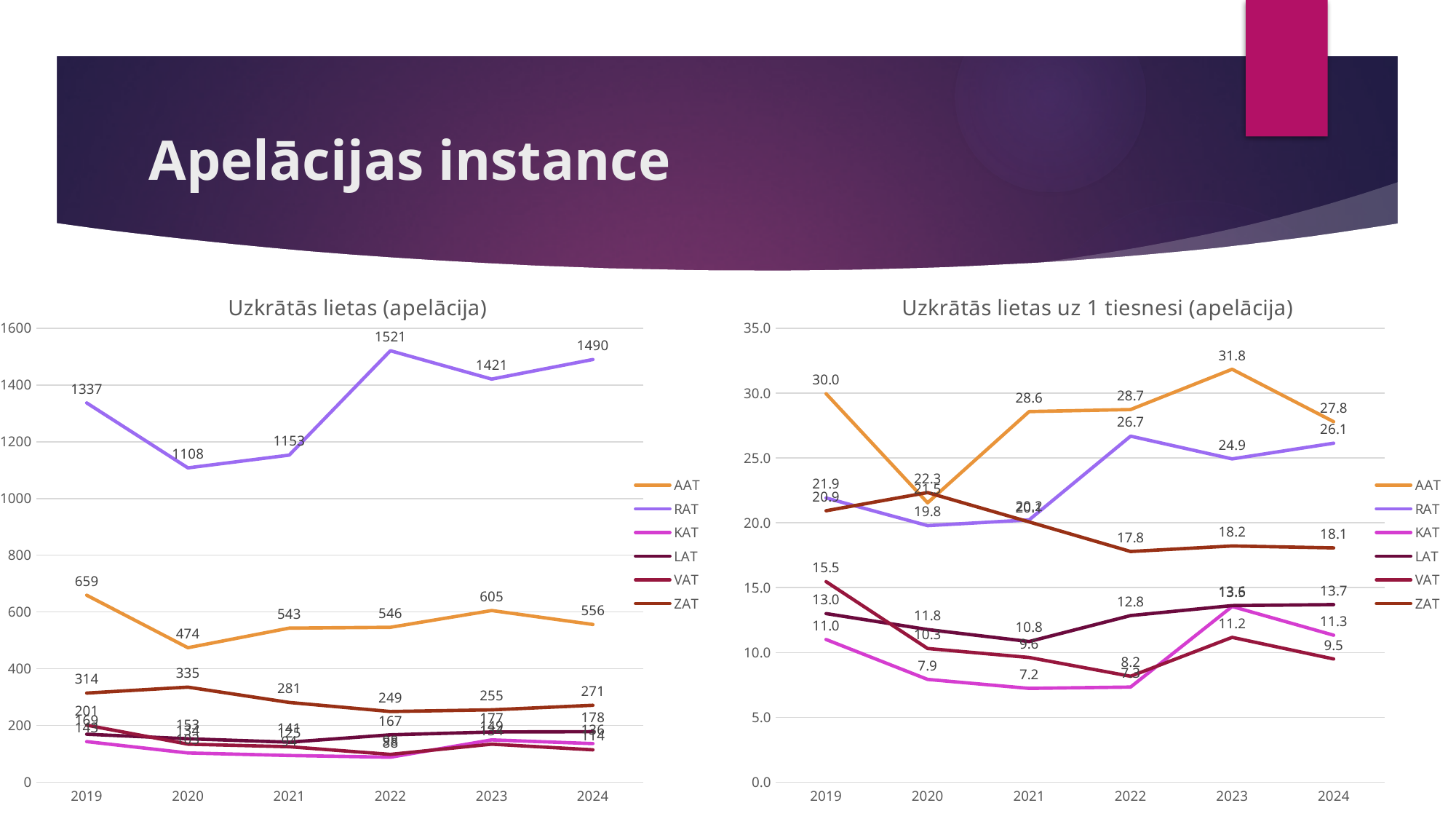
In the chart titled 'Uzkrātās lietas (apelācija)', what is the value for RAT in 2022? 1521 In the chart titled 'Uzkrātās lietas (apelācija)', which series has the higher value in 2024, RAT or AAT? RAT In the chart titled 'Uzkrātās lietas (apelācija)', in which year is the RAT value lowest? 2020 In the chart titled 'Uzkrātās lietas (apelācija)', what is the value for ZAT in 2020? 335 What kind of chart is 'Uzkrātās lietas uz 1 tiesnesi (apelācija)'? Line chart In the chart titled 'Uzkrātās lietas (apelācija)', what is the value for AAT in 2019? 659 In the chart titled 'Uzkrātās lietas (apelācija)', what is the difference between the RAT values in 2022 and 2020? 413 In the chart titled 'Uzkrātās lietas uz 1 tiesnesi (apelācija)', what is the value for AAT in 2023? 31.8 In the chart titled 'Uzkrātās lietas uz 1 tiesnesi (apelācija)', what is the value for ZAT in 2022? 17.8 In the chart titled 'Uzkrātās lietas uz 1 tiesnesi (apelācija)', in which year is the AAT value lowest? 2020 How many series does the legend of the chart titled 'Uzkrātās lietas (apelācija)' list? 6 In the chart titled 'Uzkrātās lietas uz 1 tiesnesi (apelācija)', what is the value for RAT in 2022? 26.7